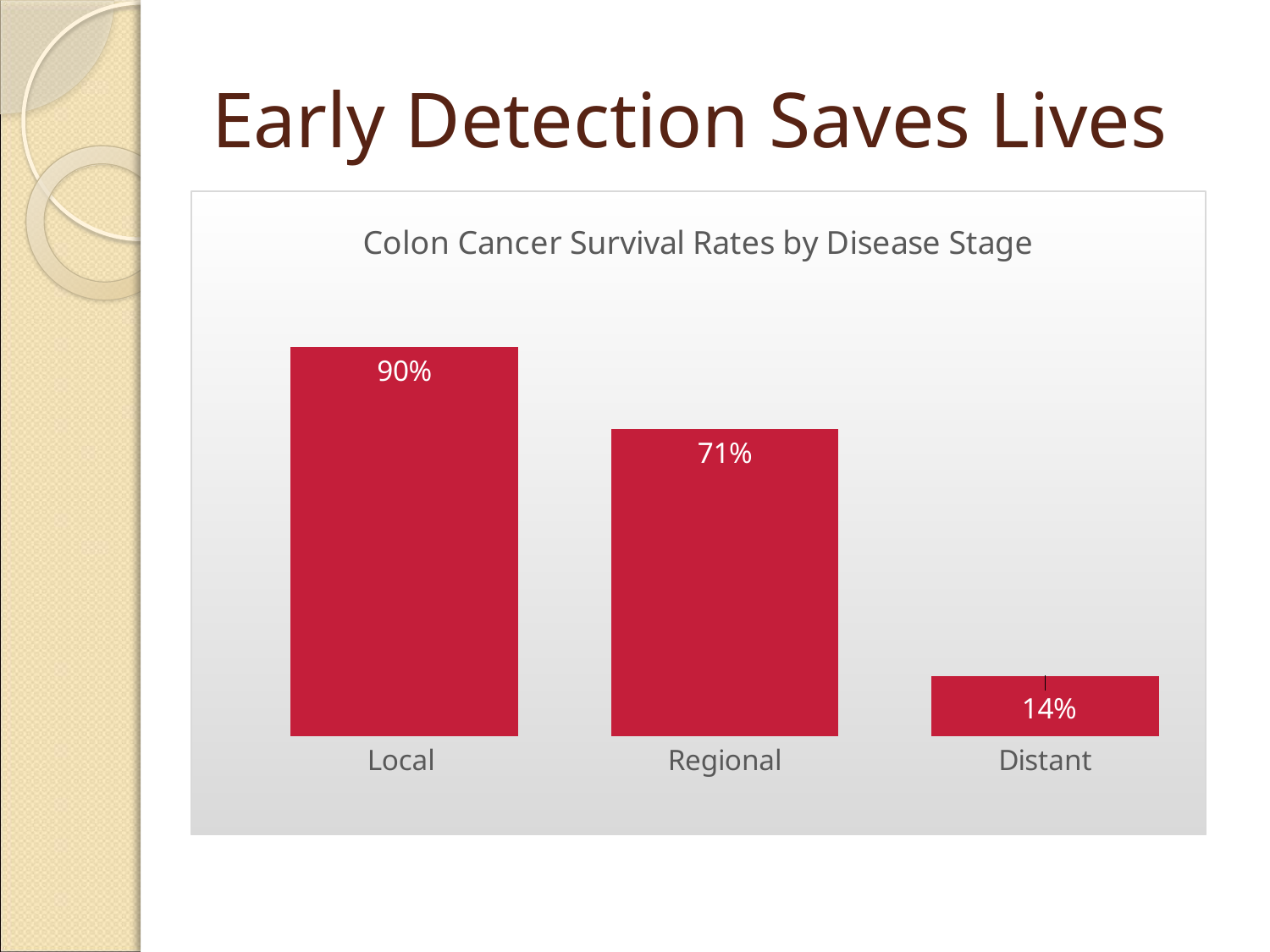
What is the survival rate for the Local stage? 90% Do the survival rates rise or fall from Local to Distant? Fall Which disease stage has the lowest survival rate? Distant What is the survival rate for the Distant stage? 14% What is the difference in survival rate between the Local and Regional stages? 19% What is the title of the chart? Colon Cancer Survival Rates by Disease Stage Which has a higher survival rate, Regional or Distant? Regional How many disease stages are shown in the chart? 3 What is the survival rate for the Regional stage? 71% Which disease stage has the highest survival rate? Local What kind of chart is shown on the slide? Bar chart What is the difference in survival rate between the Regional and Distant stages? 57%